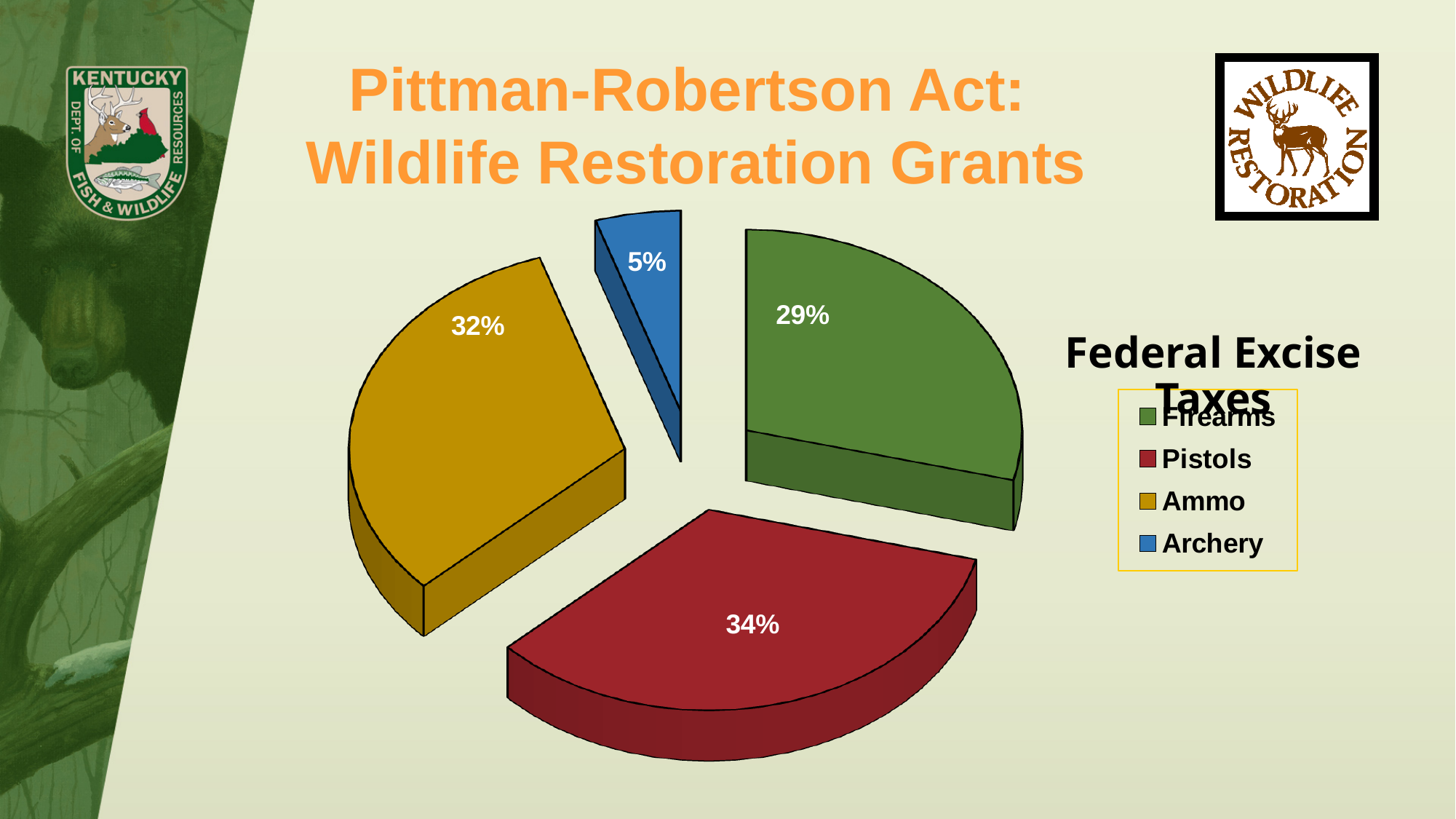
What colour is the Archery slice? Blue What kind of chart is shown on the slide? Pie chart How many slices does the pie chart have? 4 How many entries does the legend list? 4 Which category has the largest slice of the pie? Pistols Which category has the smallest slice of the pie? Archery What is the difference in percentage points between the Pistols slice and the Firearms slice? 5 What share of the pie does Pistols account for? 34% What share of the pie does Archery account for? 5% What share of the pie does Ammo account for? 32% Which is larger, the Ammo slice or the Firearms slice? Ammo